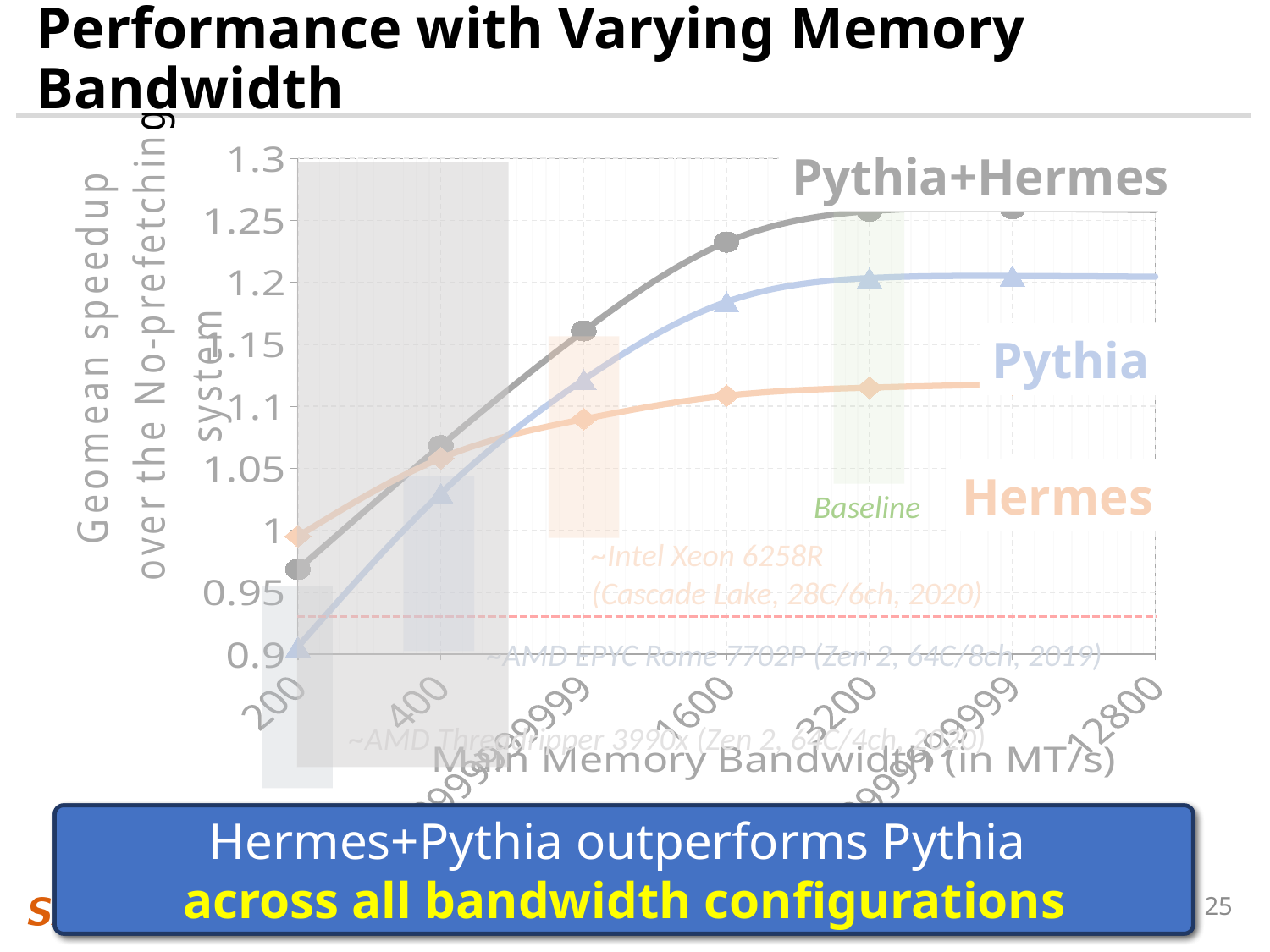
Does the Pythia+Hermes series rise or fall as memory bandwidth increases along the x axis? rise Is the value for Hermes at 3200 MT/s greater or less than 1.15? less Which series has the lowest value at 3200 MT/s? Hermes At 3200 MT/s, which is larger: the value for Pythia+Hermes or the value for Pythia? Pythia+Hermes Is the value for Pythia+Hermes at 1600 MT/s greater or less than 1.2? greater At 200 MT/s, which is larger: the value for Hermes or the value for Pythia? Hermes How many series are plotted on the chart? 3 What is the title of the y axis? Geomean speedup over the No-prefetching system What is the title of the x axis? Main Memory Bandwidth (in MT/s) What kind of chart is shown on the slide? line chart Is the value for Pythia at 200 MT/s greater or less than 0.95? less Which series has the highest value at 1600 MT/s? Pythia+Hermes